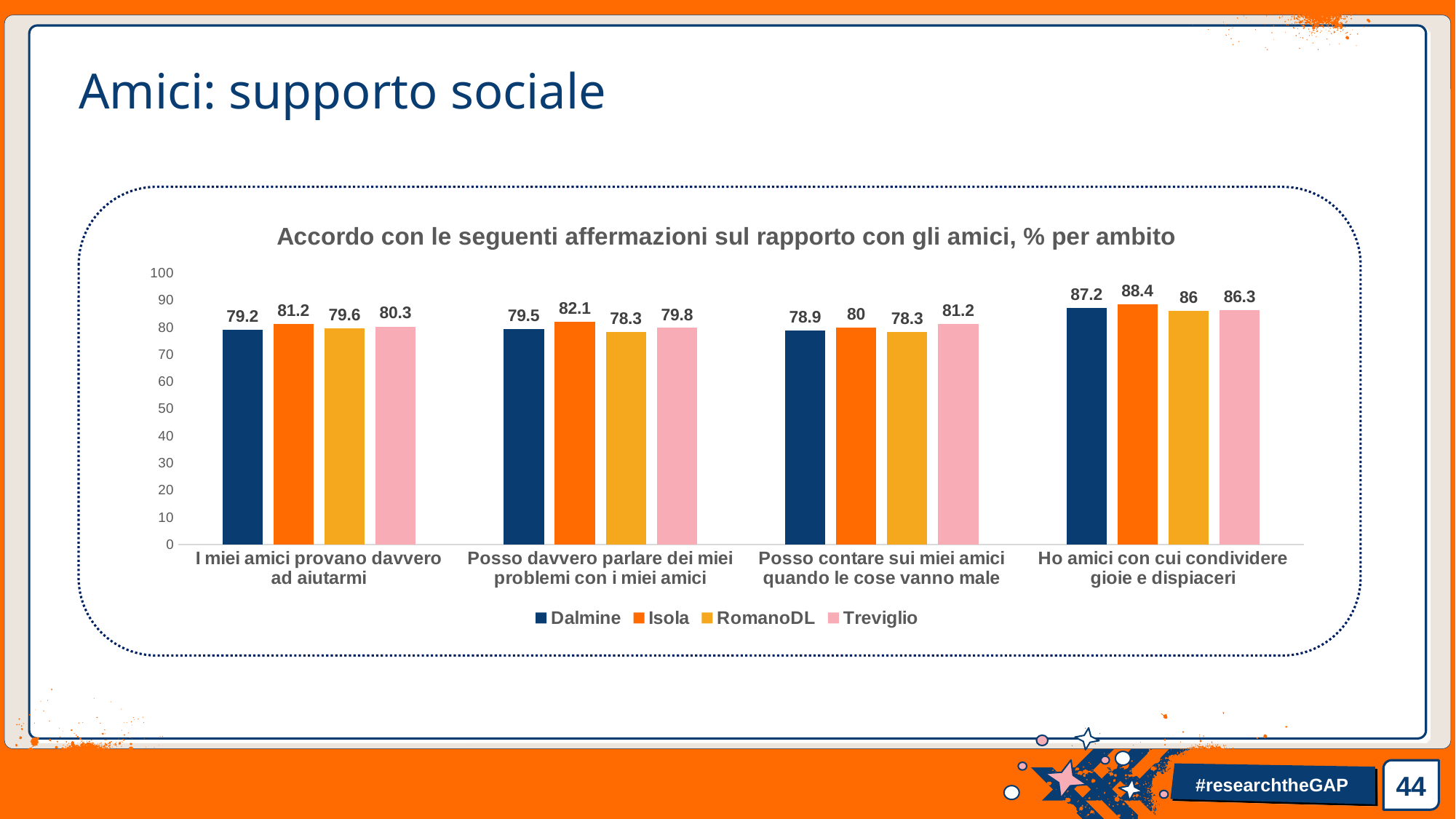
What is the value for RomanoDL in the category "Posso contare sui miei amici quando le cose vanno male"? 78.3 What is the value for Isola in the category "Ho amici con cui condividere gioie e dispiaceri"? 88.4 Which series has the lowest value in the category "Posso davvero parlare dei miei problemi con i miei amici"? RomanoDL What is the difference between the Isola and Dalmine values in the category "Posso davvero parlare dei miei problemi con i miei amici"? 2.6 What is the title of the chart? Accordo con le seguenti affermazioni sul rapporto con gli amici, % per ambito Which series has the highest value in the category "Ho amici con cui condividere gioie e dispiaceri"? Isola How many series does the legend list? 4 What is the value for Dalmine in the category "I miei amici provano davvero ad aiutarmi"? 79.2 How many categories are shown on the x axis? 4 What is the value for Treviglio in the category "Posso davvero parlare dei miei problemi con i miei amici"? 79.8 Which is larger: the Treviglio value for "Posso contare sui miei amici quando le cose vanno male" or the Treviglio value for "I miei amici provano davvero ad aiutarmi"? Posso contare sui miei amici quando le cose vanno male What kind of chart is shown on the slide? Bar chart